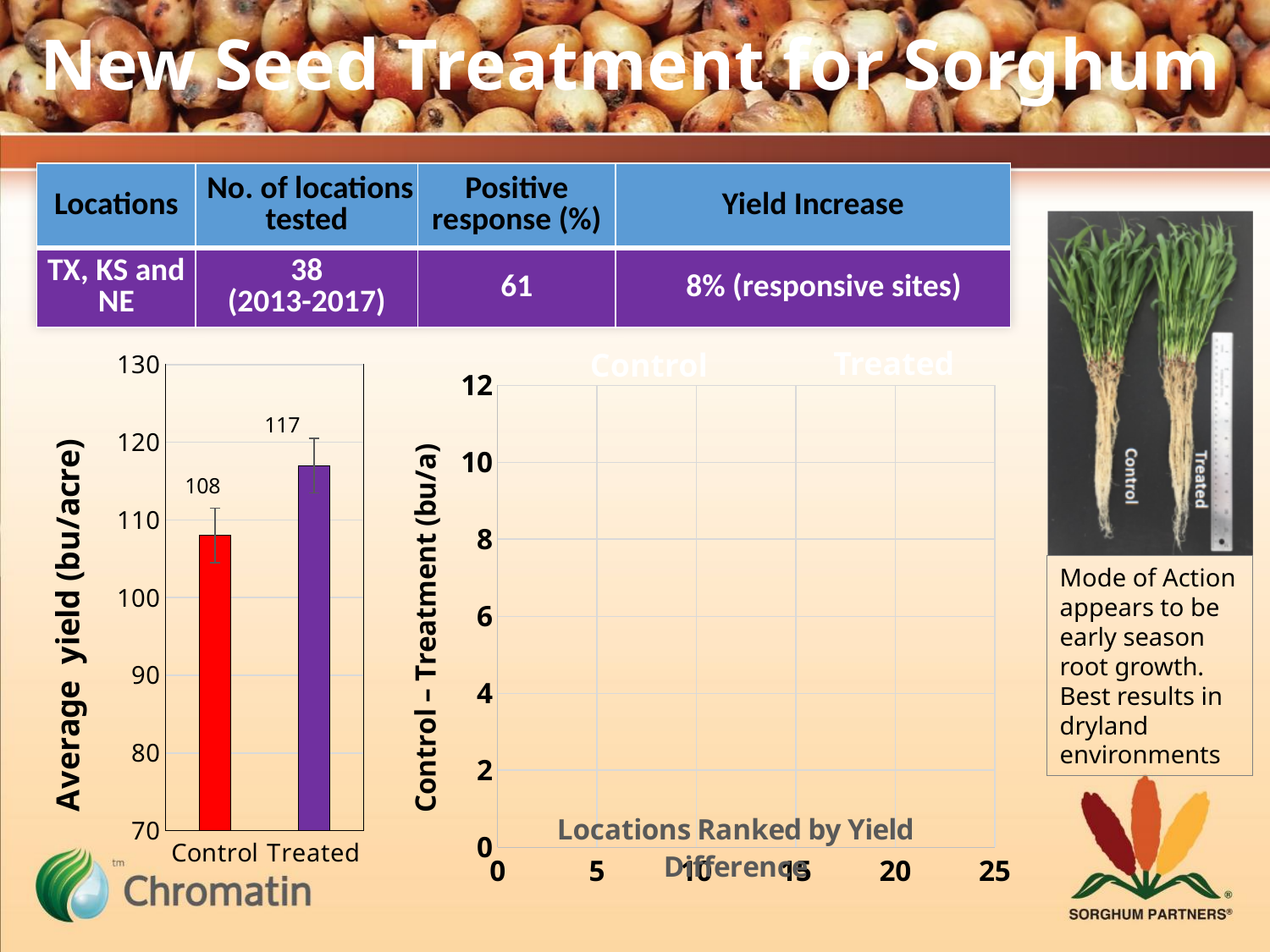
In the bar chart on the left, which category has the highest average yield? Treated In the bar chart on the left, is the value for Treated greater or less than 110? greater In the bar chart on the left, what is the average yield for Control? 108 What kind of chart is the chart on the left of the slide? bar chart In the bar chart on the left, what is the difference in average yield between Treated and Control? 9 How many categories are shown in the bar chart on the left? 2 What is the y-axis title of the bar chart on the left? Average yield (bu/acre) In the bar chart on the left, what is the average yield for Treated? 117 In the bar chart on the left, which category has the lowest average yield? Control In the bar chart on the left, is the value for Control greater or less than 110? less In the bar chart on the left, which is larger, the Control yield or the Treated yield? Treated What is the x-axis title of the chart in the middle of the slide? Locations Ranked by Yield Difference